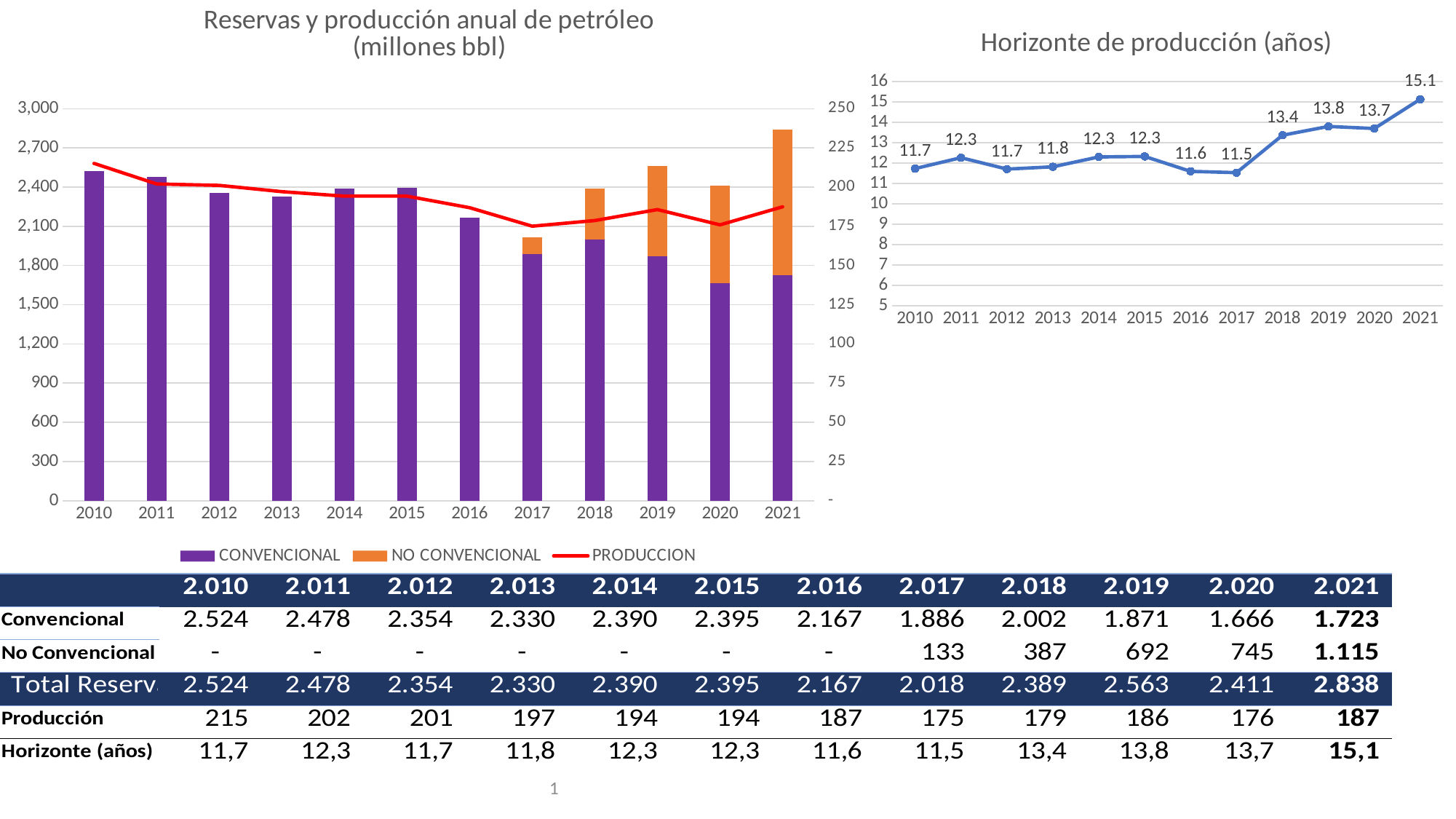
In the 'Horizonte de producción (años)' chart, which year has the highest value? 2021 In the 'Reservas y producción anual de petróleo' chart, is the PRODUCCION value for 2010 greater or less than 200 on the right axis? greater In the 'Horizonte de producción (años)' chart, what is the difference between the values for 2021 and 2020? 1.4 How many years are shown on the x axis of the 'Horizonte de producción (años)' chart? 12 In the 'Reservas y producción anual de petróleo' chart, which year has the larger CONVENCIONAL bar, 2010 or 2021? 2010 In the 'Horizonte de producción (años)' chart, do the values rise or fall from 2017 to 2021? rise How many series does the legend of the 'Reservas y producción anual de petróleo' chart list? 3 In the 'Reservas y producción anual de petróleo' chart, is the CONVENCIONAL value for 2010 greater or less than 2,400? greater In the 'Horizonte de producción (años)' chart, what is the value for 2018? 13.4 What kind of chart is the 'Horizonte de producción (años)' chart on the right? line chart In the 'Horizonte de producción (años)' chart, which year has the lowest value? 2017 What is the title of the chart on the left of the slide? Reservas y producción anual de petróleo (millones bbl)